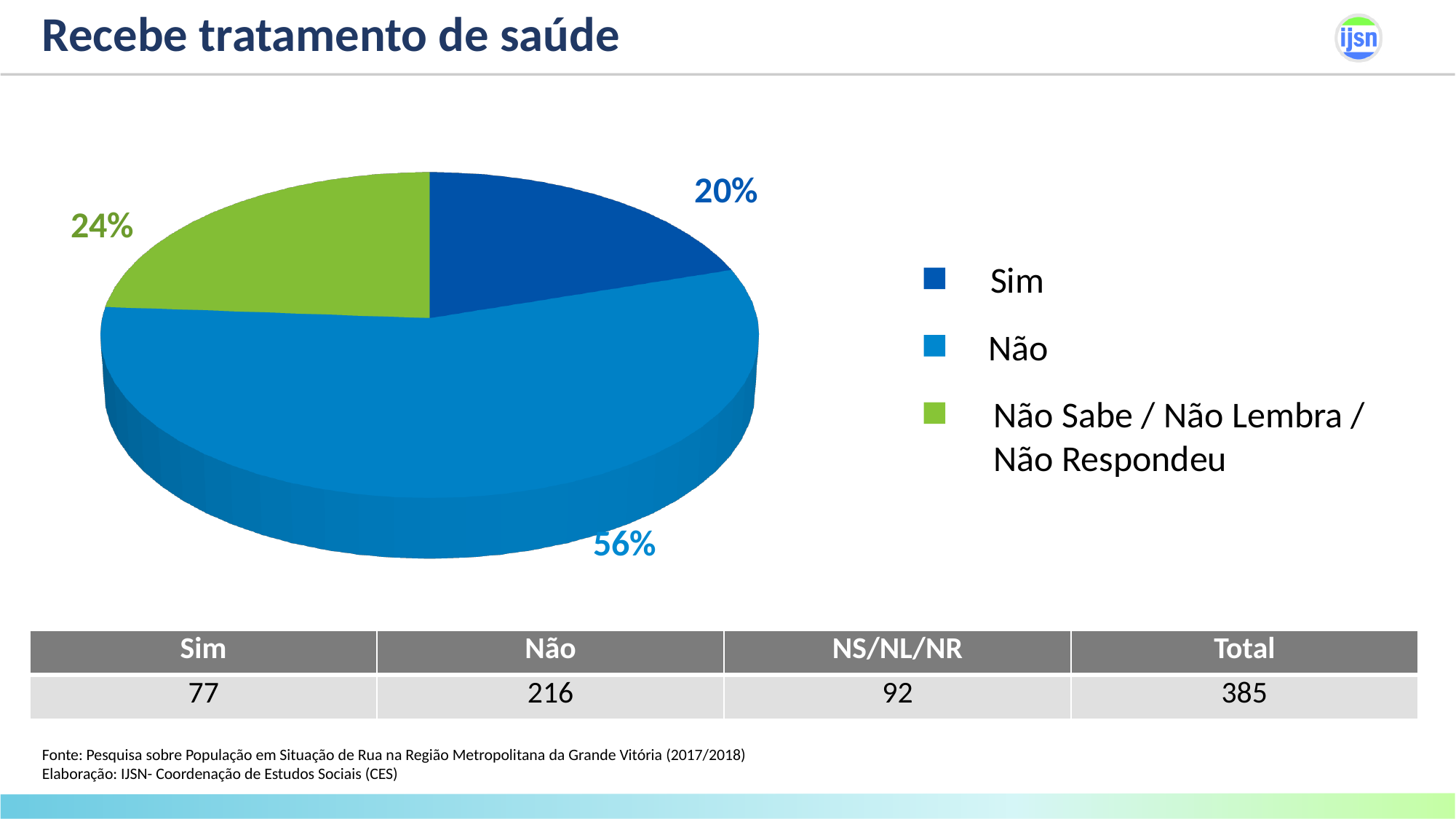
How many slices does the pie chart have? 3 Which slice is larger, 'Sim' or 'Não Sabe / Não Lembra / Não Respondeu'? Não Sabe / Não Lembra / Não Respondeu According to the table below the chart, what is the count for 'Não'? 216 What colour is the 'Não' slice in the pie chart? Light blue What percentage of the pie chart is the 'Não' slice? 56% What percentage of the pie chart is the 'Não Sabe / Não Lembra / Não Respondeu' slice? 24% Which category has the largest slice of the pie chart? Não What is the title of the slide containing the chart? Recebe tratamento de saúde What percentage of the pie chart is the 'Sim' slice? 20% What kind of chart is shown on the slide? Pie chart What is the difference in percentage points between the 'Não' slice and the 'Sim' slice? 36 Which category has the smallest slice of the pie chart? Sim